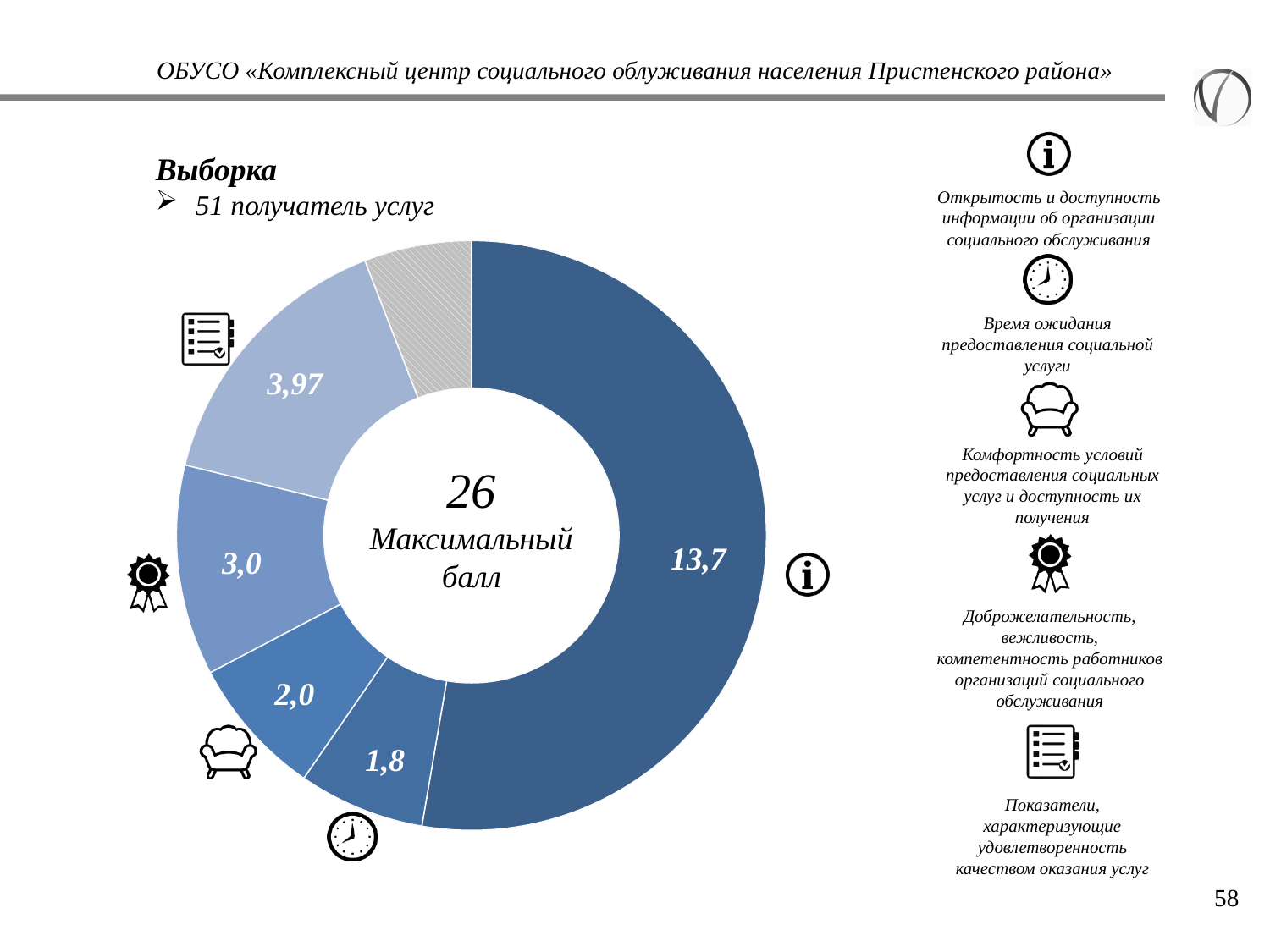
What value is shown for the slice marked with the armchair icon (Комфортность условий)? 2,0 Which labelled slice has the smallest value? 1,8 (Время ожидания предоставления социальной услуги) What maximum score (Максимальный балл) is printed in the centre of the donut chart? 26 What value is shown for the slice marked with the medal icon (Доброжелательность, вежливость, компетентность работников)? 3,0 How many slices of the donut chart have printed data labels? 5 What kind of chart is shown on the slide? Donut (pie) chart What value is shown for the slice marked with the checklist icon (Показатели, характеризующие удовлетворенность качеством оказания услуг)? 3,97 Which is larger: the slice for Комфортность условий or the slice for Доброжелательность, вежливость, компетентность работников? Доброжелательность, вежливость, компетентность работников (3,0) What value is shown for the slice marked with the clock icon (Время ожидания предоставления социальной услуги)? 1,8 Which labelled slice has the largest value? 13,7 (Открытость и доступность информации) What is the difference between the largest labelled slice (13,7) and the slice labelled 3,97? 9,73 What value is shown for the slice marked with the information icon (Открытость и доступность информации)? 13,7